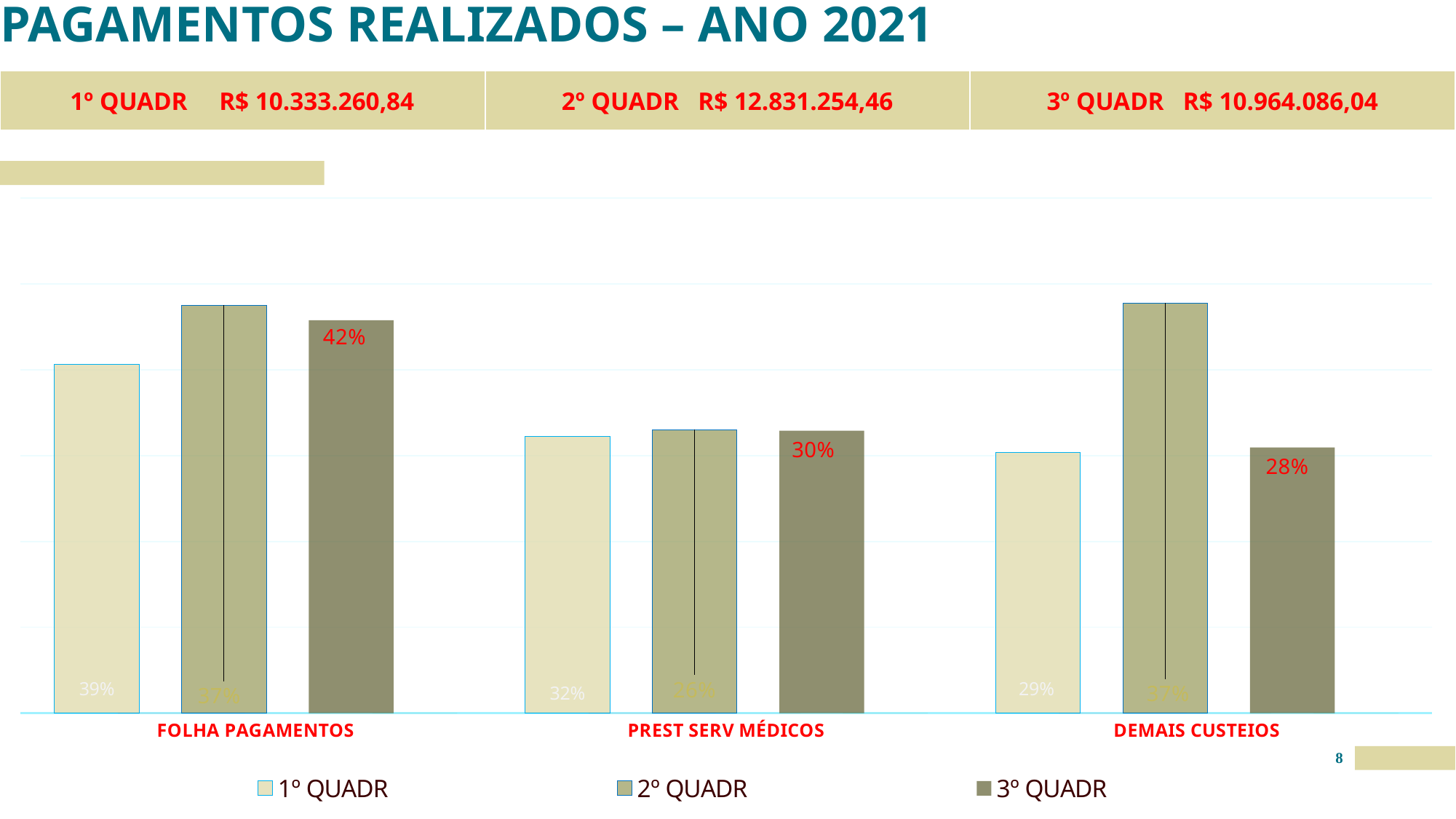
Among the 3º QUADR bars, which category has the lowest value? DEMAIS CUSTEIOS What is the value of the 3º QUADR bar for FOLHA PAGAMENTOS? 42% Among the 3º QUADR bars, which category has the highest value? FOLHA PAGAMENTOS What is the difference between the 3º QUADR values for FOLHA PAGAMENTOS and DEMAIS CUSTEIOS? 14 percentage points What is the value of the 1º QUADR bar for FOLHA PAGAMENTOS? 39% How many series does the chart legend list? 3 What type of chart is shown on the slide? Bar chart What is the value of the 1º QUADR bar for PREST SERV MÉDICOS? 32% What is the value of the 3º QUADR bar for PREST SERV MÉDICOS? 30% What is the value of the 3º QUADR bar for DEMAIS CUSTEIOS? 28% For FOLHA PAGAMENTOS, which is larger: the 1º QUADR bar or the 3º QUADR bar? 3º QUADR How many categories are shown on the x axis of the chart? 3